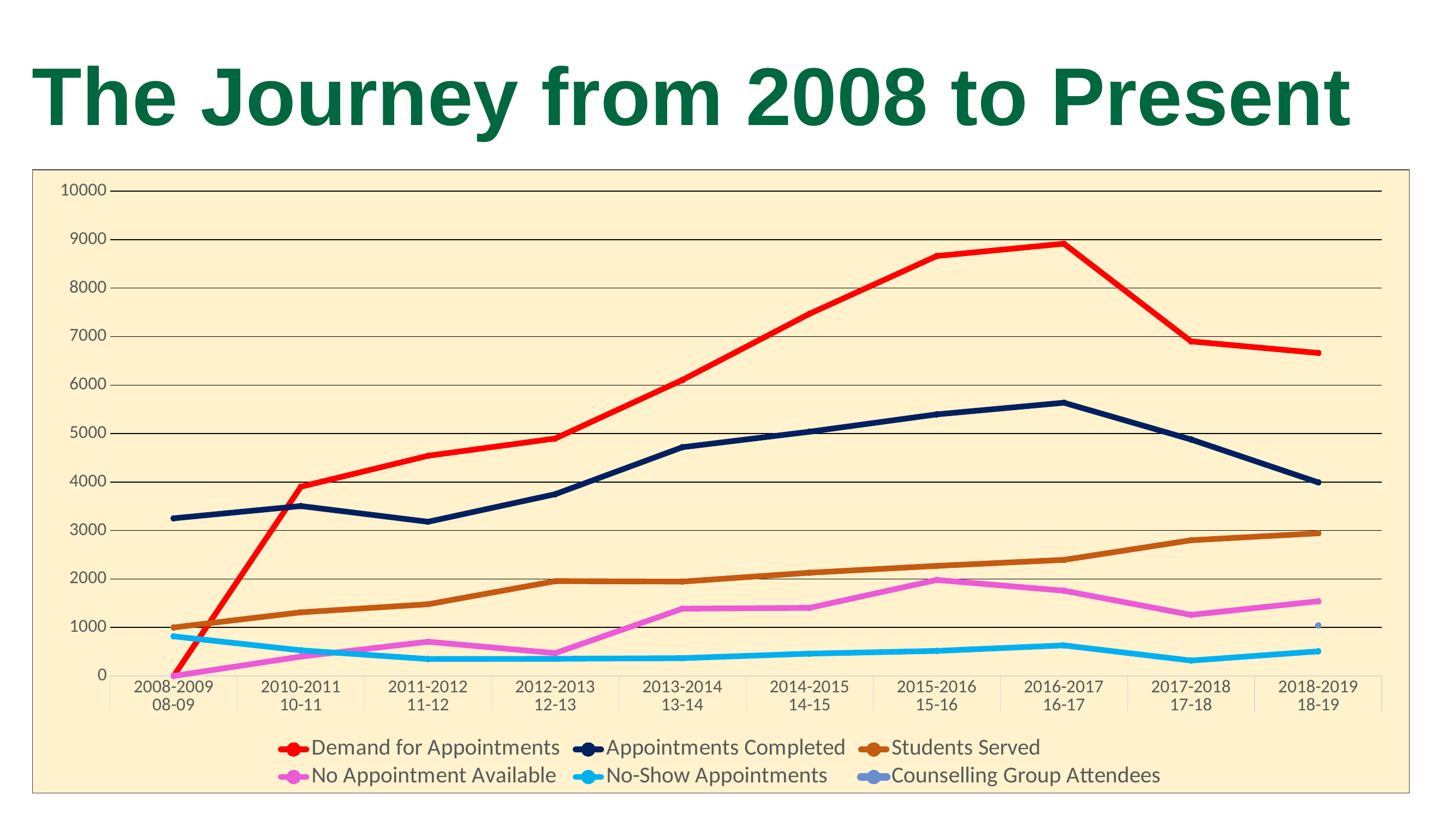
Is the value for Demand for Appointments in 2016-2017 greater or less than 8000? greater Does Demand for Appointments rise or fall from 2016-2017 to 2018-2019? fall Is the value for Appointments Completed in 2016-2017 greater or less than 5000? greater In 2018-2019, which is larger: Demand for Appointments or Appointments Completed? Demand for Appointments What kind of chart is shown on the slide? line chart How many series does the legend list? 6 What is the title of the slide? The Journey from 2008 to Present In which year does Demand for Appointments reach its highest value? 2016-2017 What is the value of Demand for Appointments in 2008-2009? 0 In which year is Demand for Appointments at its lowest? 2008-2009 Is the value for No-Show Appointments in 2008-2009 greater or less than 1000? less How many academic years are shown along the x axis? 10